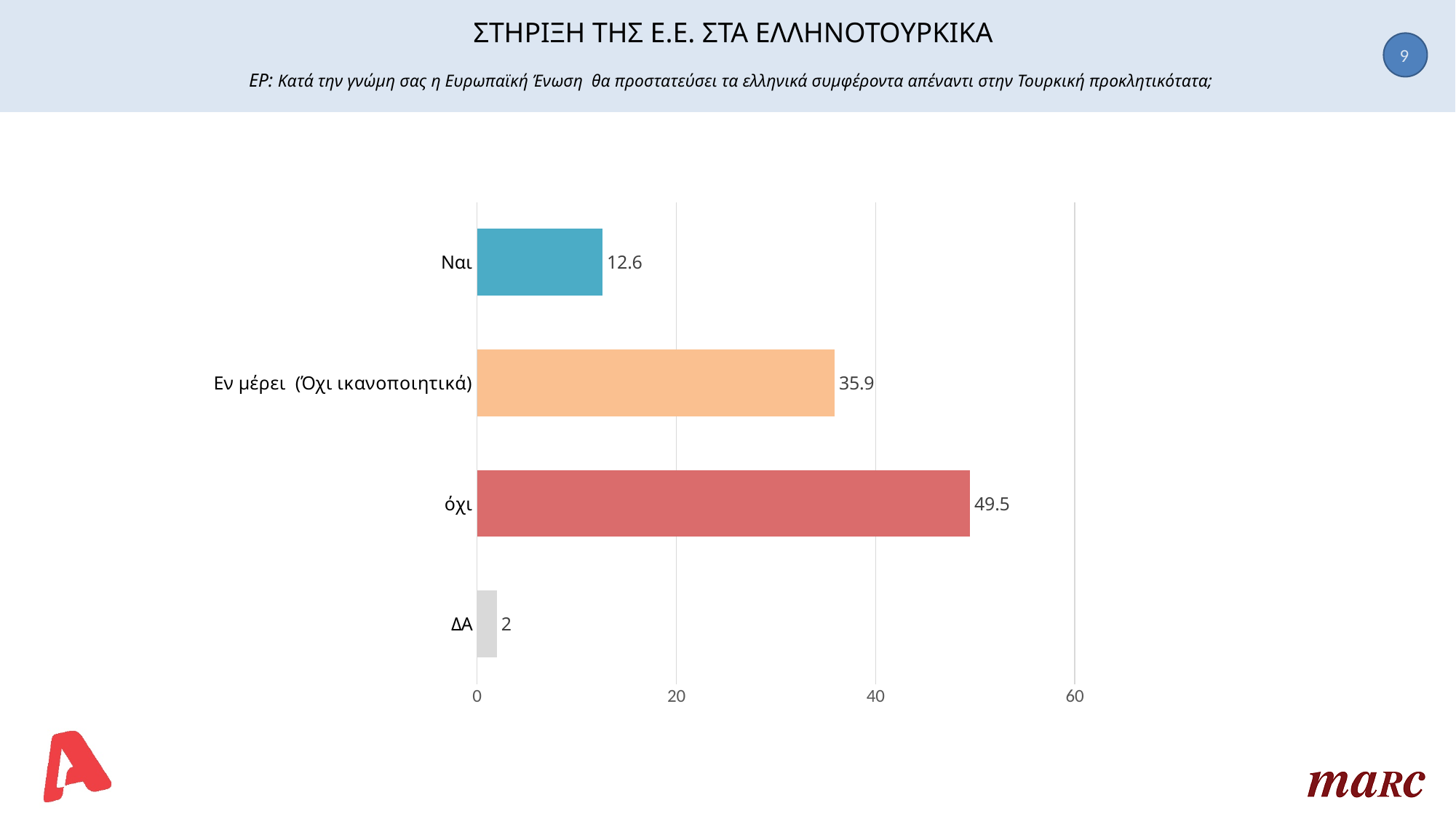
What is the value for ΔΑ? 2 What is the difference between the values for όχι and Ναι? 36.9 What is the value for όχι? 49.5 What kind of chart is shown on the slide? bar chart How many categories are shown in the chart? 4 Which is larger, the value for Ναι or the value for Εν μέρει (Όχι ικανοποιητικά)? Εν μέρει (Όχι ικανοποιητικά) Is the value for όχι greater or less than 40? greater Which category has the lowest value? ΔΑ Which category has the highest value? όχι What is the value for Ναι? 12.6 What is the value for Εν μέρει (Όχι ικανοποιητικά)? 35.9 What is the difference between the values for όχι and Εν μέρει (Όχι ικανοποιητικά)? 13.6